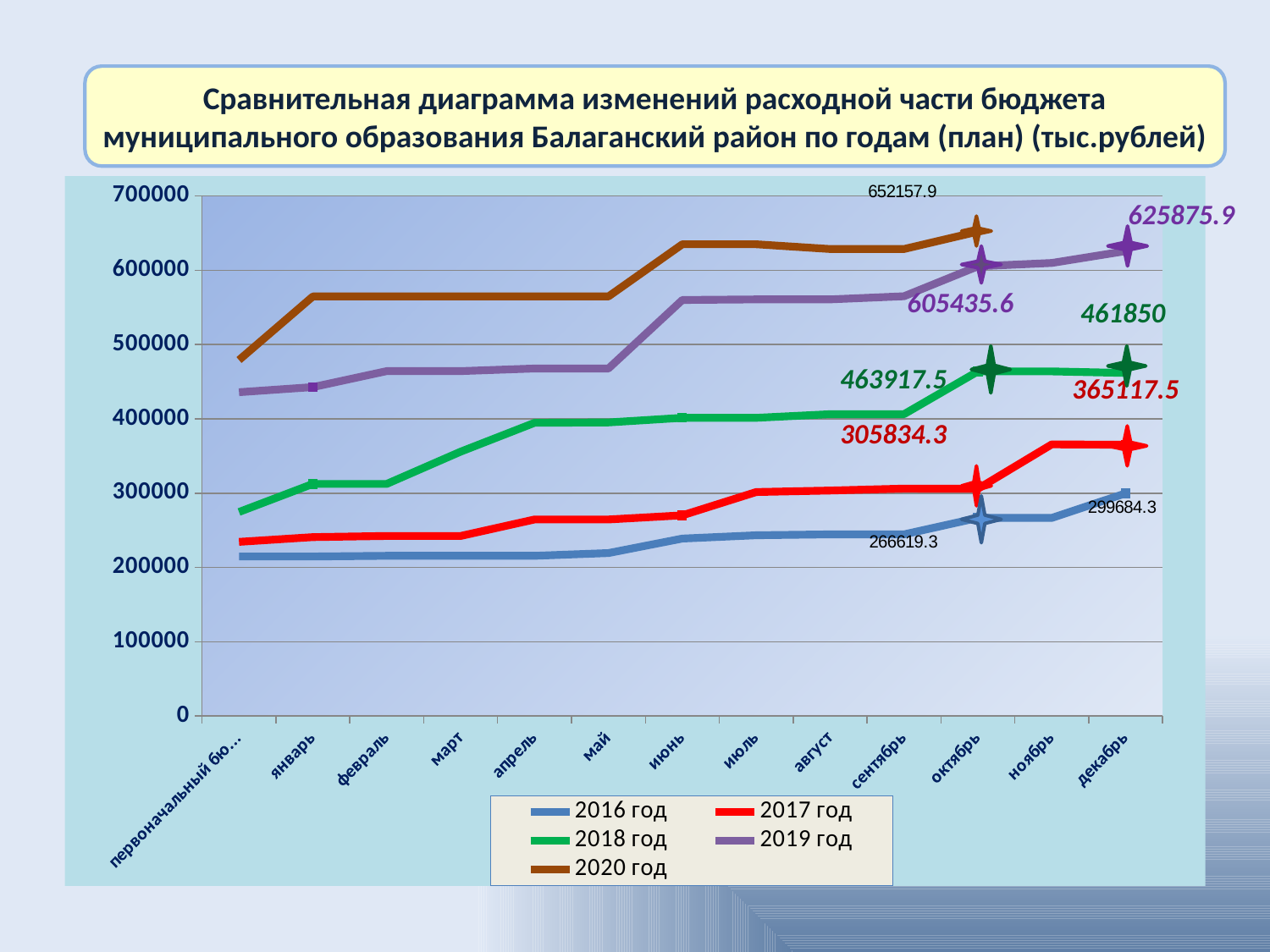
What is the value for 2018 год in октябрь? 463917.5 What is the value for 2020 год in октябрь? 652157.9 What is the value for 2017 год in декабрь? 365117.5 What is the value for 2016 год in октябрь? 266619.3 What is the difference between the 2019 год values in декабрь and октябрь? 20440.3 Does the 2018 год line generally rise or fall from январь to декабрь? rise Is the value for 2020 год in январь greater or less than 500000? greater How many series does the legend list? 5 What kind of chart is shown on the slide? line chart Which series has the highest value in октябрь? 2020 год Which series has the lowest value in декабрь? 2016 год What is the value for 2019 год in декабрь? 625875.9